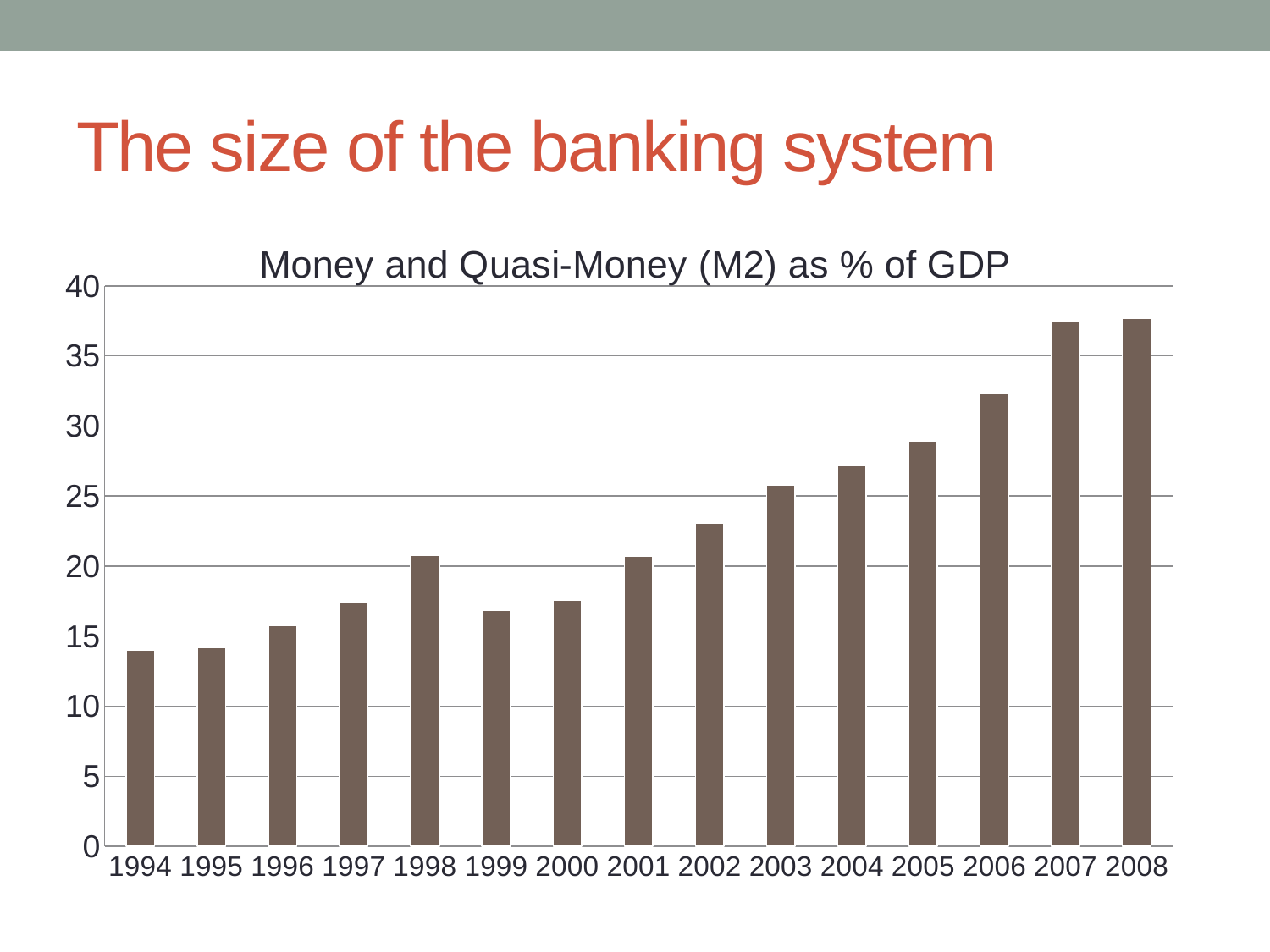
Which year has the larger value, 1998 or 1999? 1998 Is the value for 2007 greater or less than 35? greater Is the value for 2006 greater or less than 30? greater How many years are shown on the x axis of the chart? 15 Overall, do the values rise or fall from 1994 to 2008? rise What is the title of the chart? Money and Quasi-Money (M2) as % of GDP Is the value for 1999 greater or less than 20? less What type of chart is shown on the slide? bar chart Which year has the larger value, 2005 or 2006? 2006